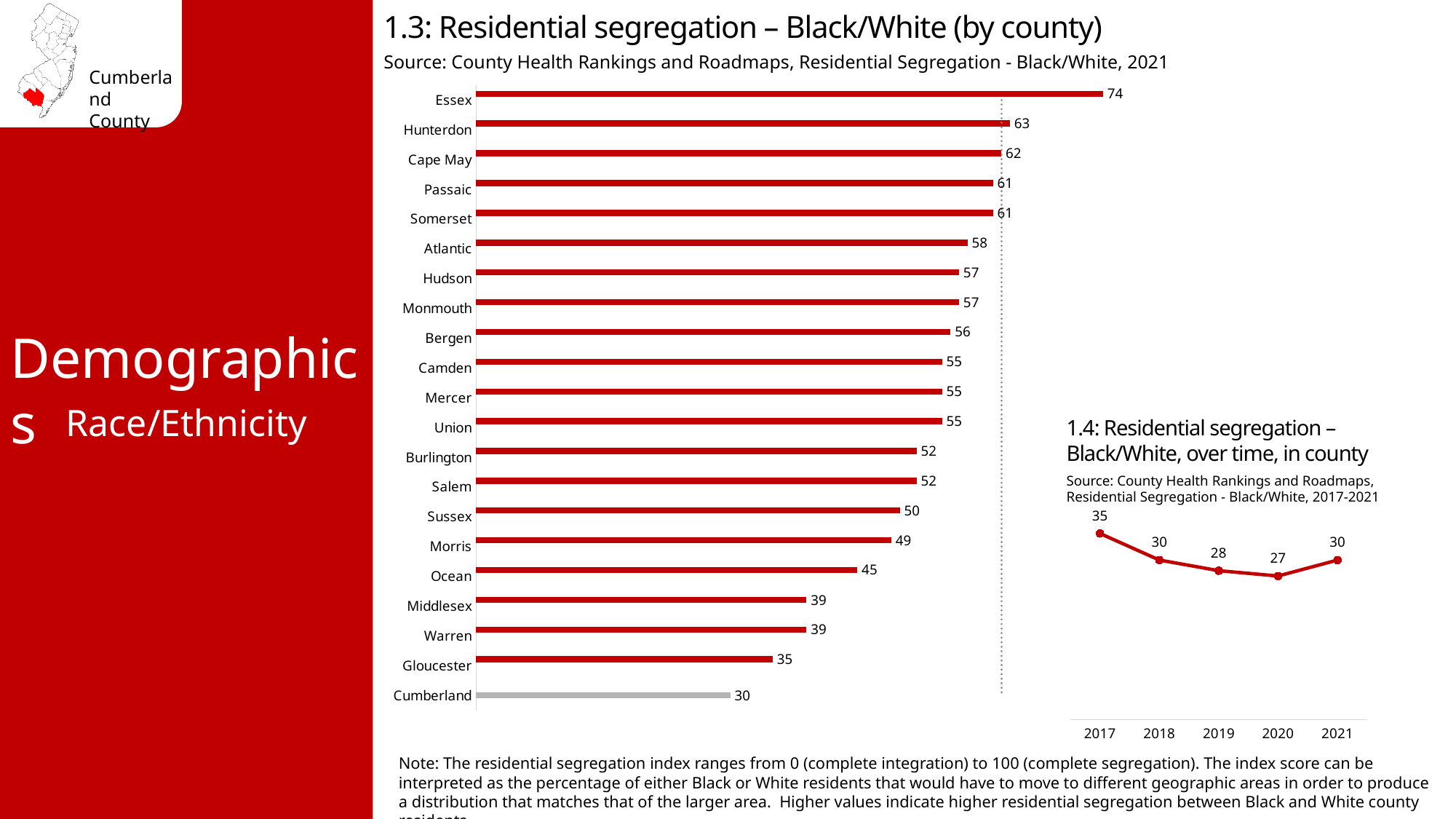
In the chart '1.3: Residential segregation – Black/White (by county)', which county has the highest value? Essex In the chart '1.3: Residential segregation – Black/White (by county)', what is the value for Essex? 74 In the chart '1.4: Residential segregation – Black/White, over time, in county', what is the value for 2020? 27 In the chart '1.4: Residential segregation – Black/White, over time, in county', which year has the highest value? 2017 In the chart '1.4: Residential segregation – Black/White, over time, in county', what is the difference between the values for 2017 and 2020? 8 In the chart '1.3: Residential segregation – Black/White (by county)', what is the difference between the values for Essex and Cumberland? 44 What kind of chart is '1.3: Residential segregation – Black/White (by county)'? Bar chart In the chart '1.3: Residential segregation – Black/White (by county)', what is the value for Cumberland? 30 What kind of chart is '1.4: Residential segregation – Black/White, over time, in county'? Line chart In the chart '1.3: Residential segregation – Black/White (by county)', which county has the lowest value? Cumberland How many counties are shown in the chart '1.3: Residential segregation – Black/White (by county)'? 21 In the chart '1.3: Residential segregation – Black/White (by county)', which has a larger value, Ocean or Gloucester? Ocean